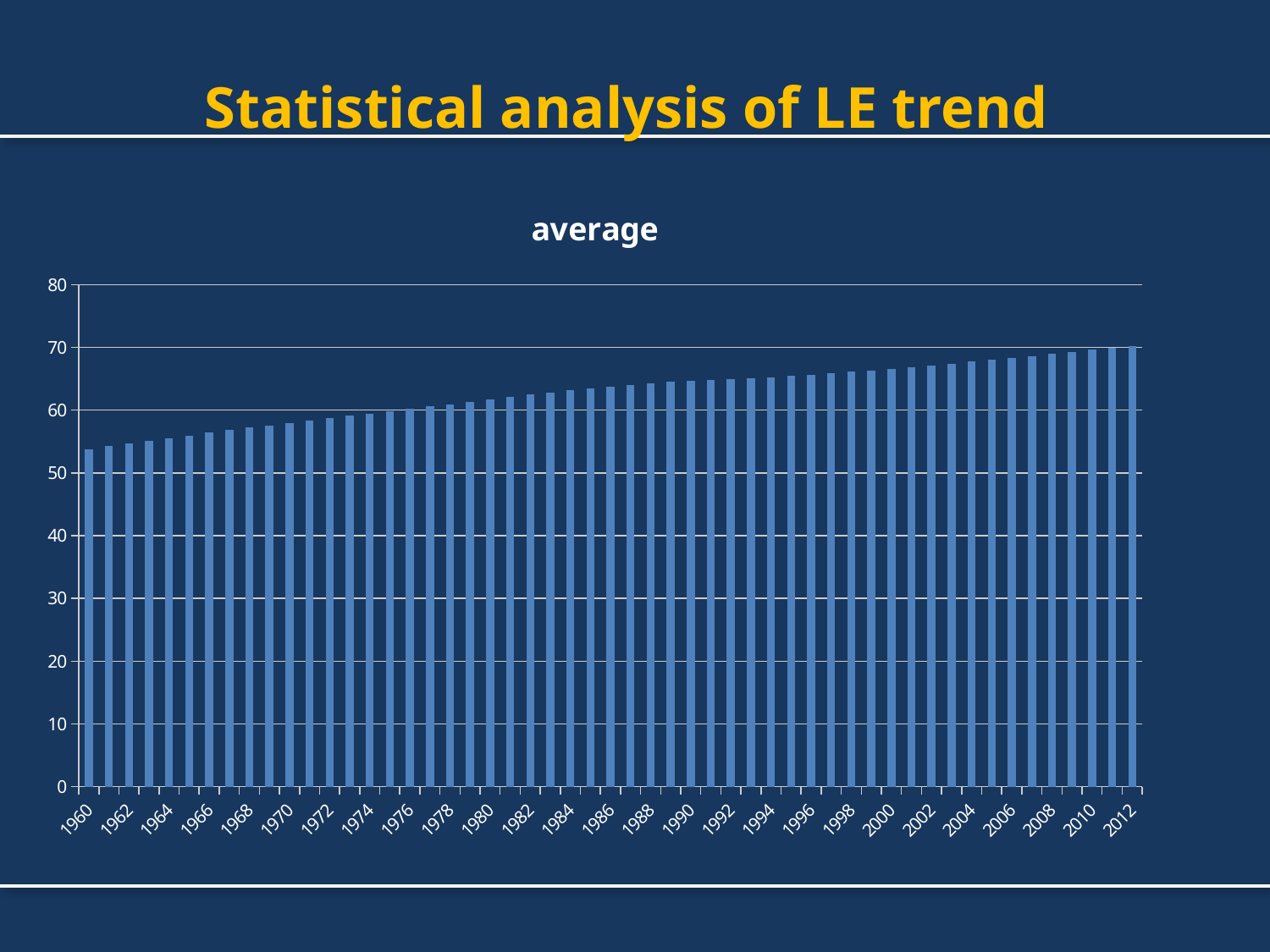
How many bars are plotted in the chart? 53 Which year has the lowest value? 1960 Which year has the highest value? 2012 What is the highest value shown on the vertical axis? 80 Is the value for 1960 greater or less than 50? greater Do the values rise or fall from 1960 to 2012? rise Is the value for 1990 greater or less than 60? greater Is the value for 1960 greater or less than 60? less What kind of chart is shown on the slide? bar chart What is the title of the chart? average Which is larger, the value for 1970 or the value for 2000? 2000